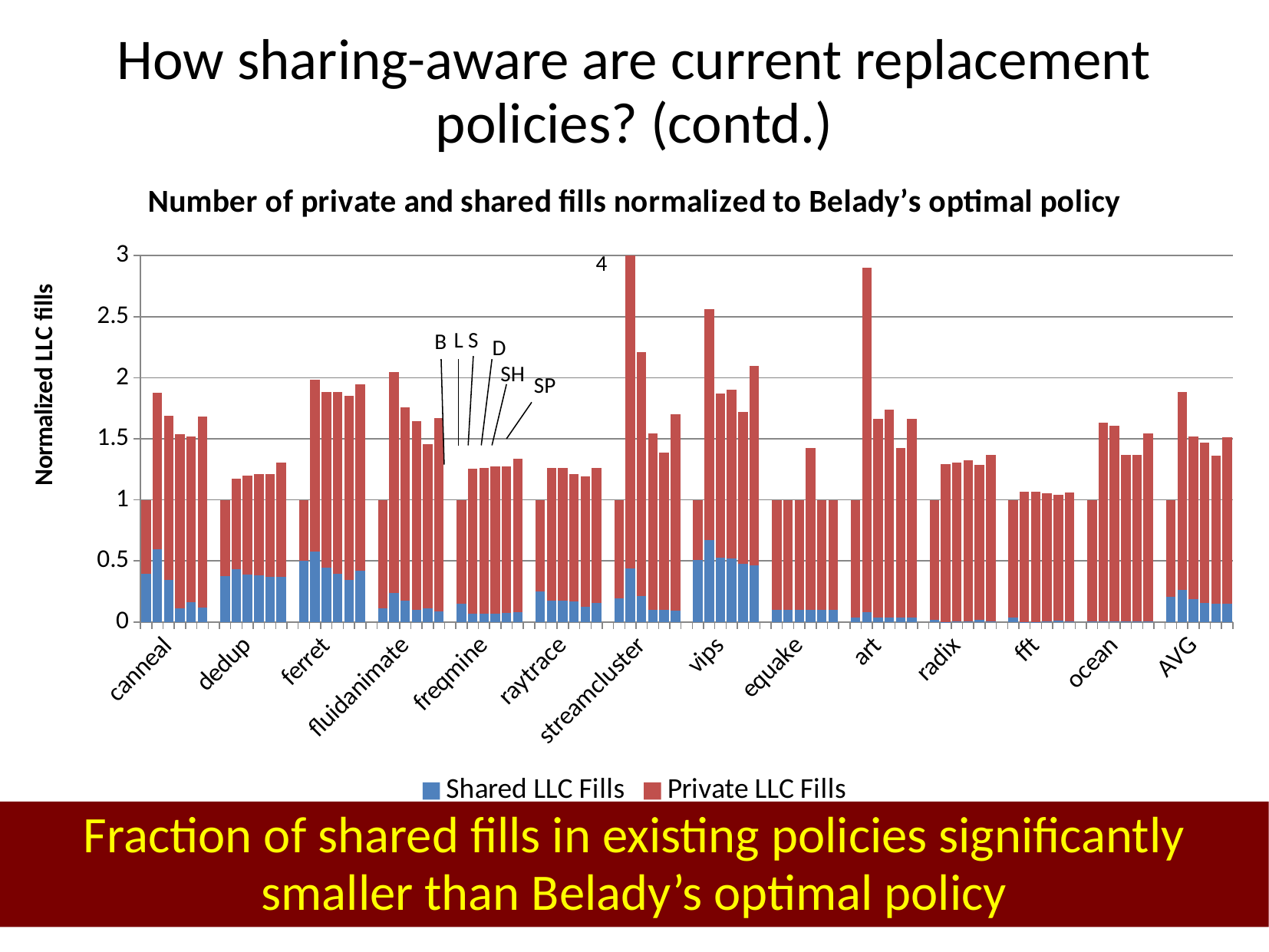
Which group has the taller tallest bar, art or radix? art Is the tallest bar in the ferret group greater or less than 1.5? greater What is the label on the y axis? Normalized LLC fills Is the tallest bar in the fft group greater or less than 1.5? less How many series does the legend list? 2 How many benchmark categories are shown along the x axis? 14 What kind of chart is shown on the slide? bar chart What is the title of the chart? Number of private and shared fills normalized to Belady's optimal policy Which category contains the tallest bar in the chart? streamcluster What value is printed as a data label above the tallest bar in the streamcluster group? 4 Is the tallest bar in the dedup group greater or less than 1.5? less